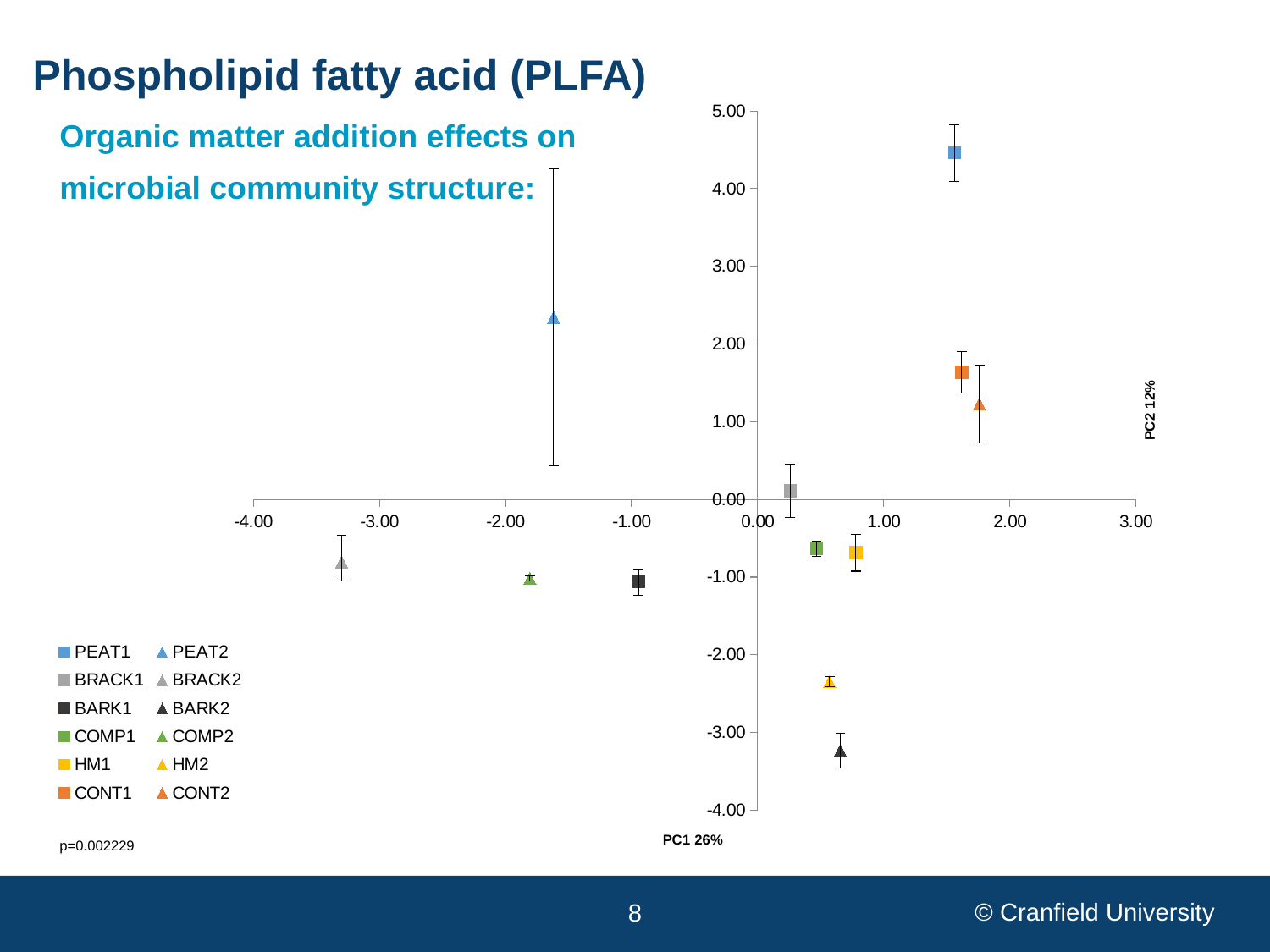
Which series has the lowest PC2 value? BARK2 Is the PC1 value for PEAT2 greater or less than -1.00? less What kind of chart is shown on the slide? scatter plot Is the PC2 value for BARK2 greater or less than -3.00? less Which series has the highest PC2 value? PEAT1 How many series does the legend list? 12 Which has the higher PC2 value, CONT1 or CONT2? CONT1 Which series has the lowest PC1 value (furthest left)? BRACK2 Is the PC2 value for PEAT1 greater or less than 4.00? greater What is the label of the horizontal axis? PC1 26% What is the label of the vertical axis? PC2 12%